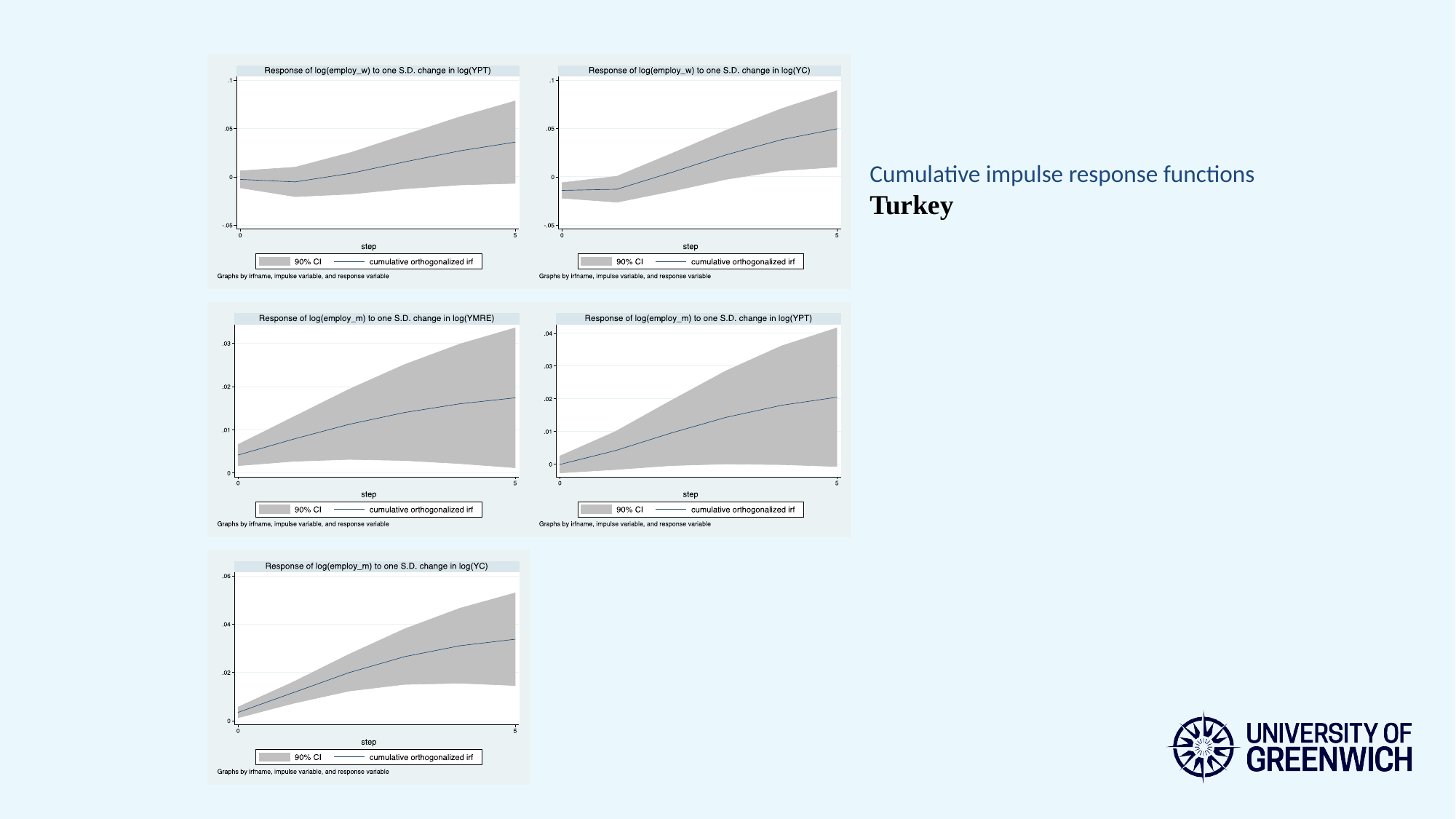
What kind of chart is "Response of log(employ_w) to one S.D. change in log(YPT)"? line chart In the chart "Response of log(employ_m) to one S.D. change in log(YC)", is the cumulative orthogonalized irf at step 5 greater or less than .02? greater In the chart "Response of log(employ_m) to one S.D. change in log(YC)", does the cumulative orthogonalized irf rise or fall along the step axis? rise In the chart "Response of log(employ_w) to one S.D. change in log(YPT)", does the cumulative orthogonalized irf rise or fall as step increases from 0 to 5? rise In the chart "Response of log(employ_w) to one S.D. change in log(YPT)", is the cumulative orthogonalized irf at step 5 greater or less than .05? less How many entries does the legend of the chart "Response of log(employ_m) to one S.D. change in log(YMRE)" list? 2 What confidence interval level is shown in the legend of the chart "Response of log(employ_m) to one S.D. change in log(YPT)"? 90% CI In the chart "Response of log(employ_m) to one S.D. change in log(YMRE)", is the cumulative orthogonalized irf at step 5 greater or less than .01? greater What is the x-axis label of the chart "Response of log(employ_w) to one S.D. change in log(YC)"? step How many charts are shown on the slide? 5